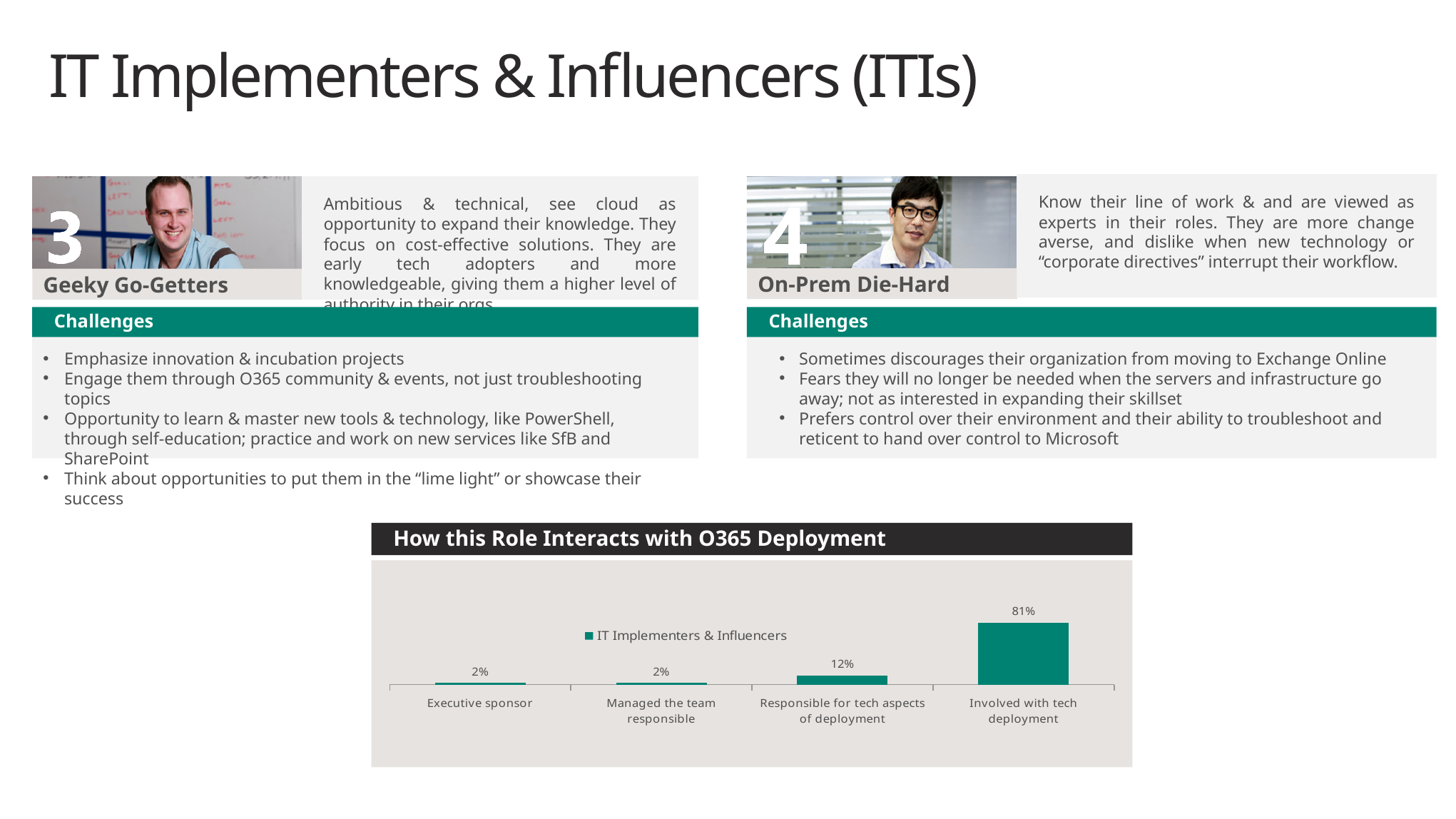
Which is larger, "Involved with tech deployment" or "Responsible for tech aspects of deployment"? Involved with tech deployment How many series does the legend list? 1 What is the title of the chart? How this Role Interacts with O365 Deployment What is the value for "Responsible for tech aspects of deployment"? 12% What is the difference between "Responsible for tech aspects of deployment" and "Executive sponsor"? 10% What is the value for "Executive sponsor"? 2% How many categories are shown on the x axis? 4 What is the value for "Involved with tech deployment"? 81% What is the difference between "Involved with tech deployment" and "Responsible for tech aspects of deployment"? 69% Which category has the highest value? Involved with tech deployment What is the value for "Managed the team responsible"? 2% What kind of chart is shown? Bar chart